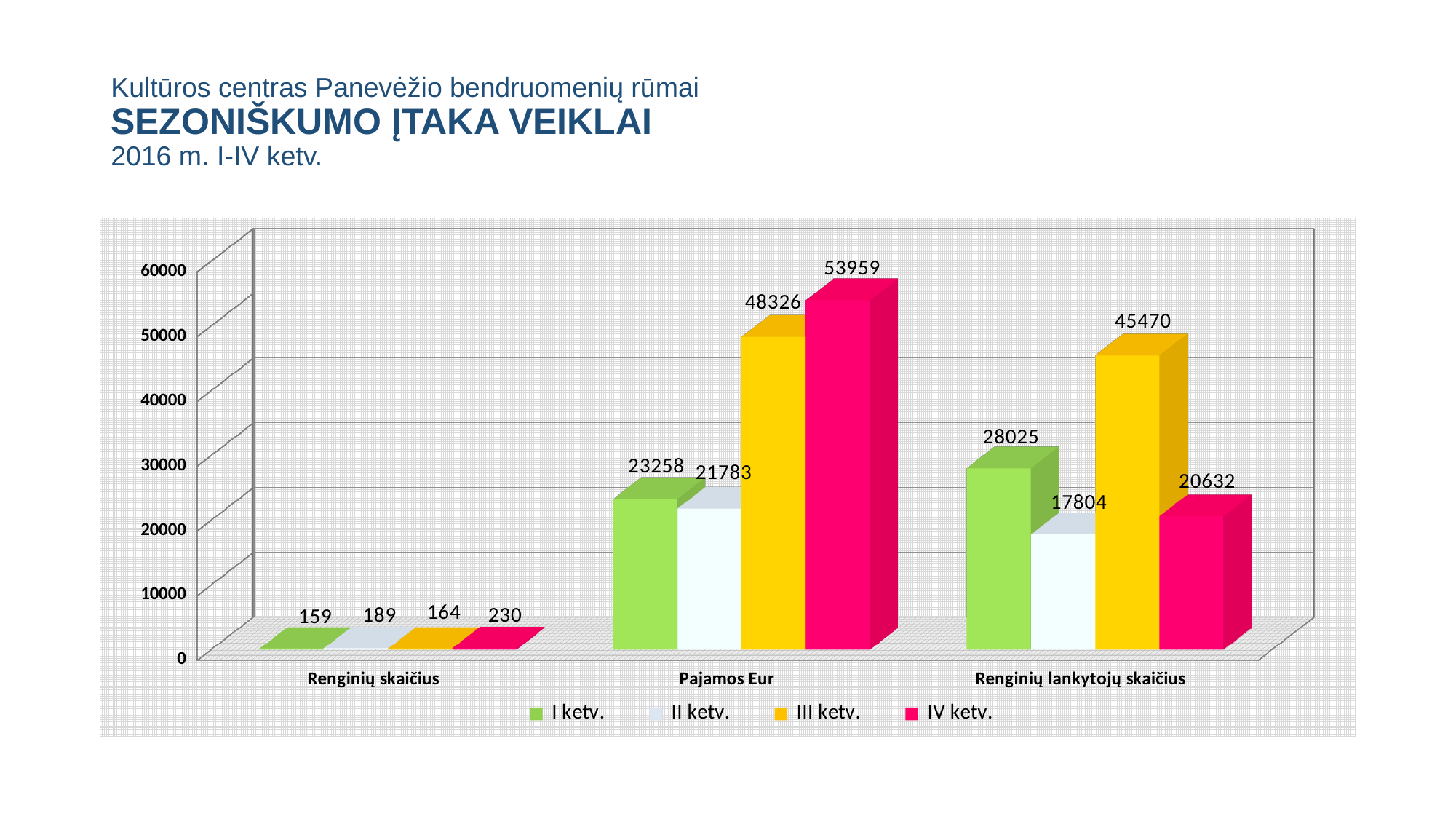
What kind of chart is shown on the slide? bar chart How many categories are shown on the x axis? 3 How many series does the legend list? 4 Is the value for III ketv. in the Renginių lankytojų skaičius category greater or less than 40000? greater What is the difference between the I ketv. and II ketv. values in the Renginių lankytojų skaičius category? 10221 What is the value for I ketv. in the Renginių skaičius category? 159 Which quarter has the lowest value in the Pajamos Eur category? II ketv. What is the value for II ketv. in the Renginių lankytojų skaičius category? 17804 What is the value for IV ketv. in the Pajamos Eur category? 53959 In the Renginių skaičius category, which is larger: the value for II ketv. or the value for III ketv.? II ketv. What is the difference between the IV ketv. and III ketv. values in the Pajamos Eur category? 5633 Which quarter has the highest value in the Renginių lankytojų skaičius category? III ketv.